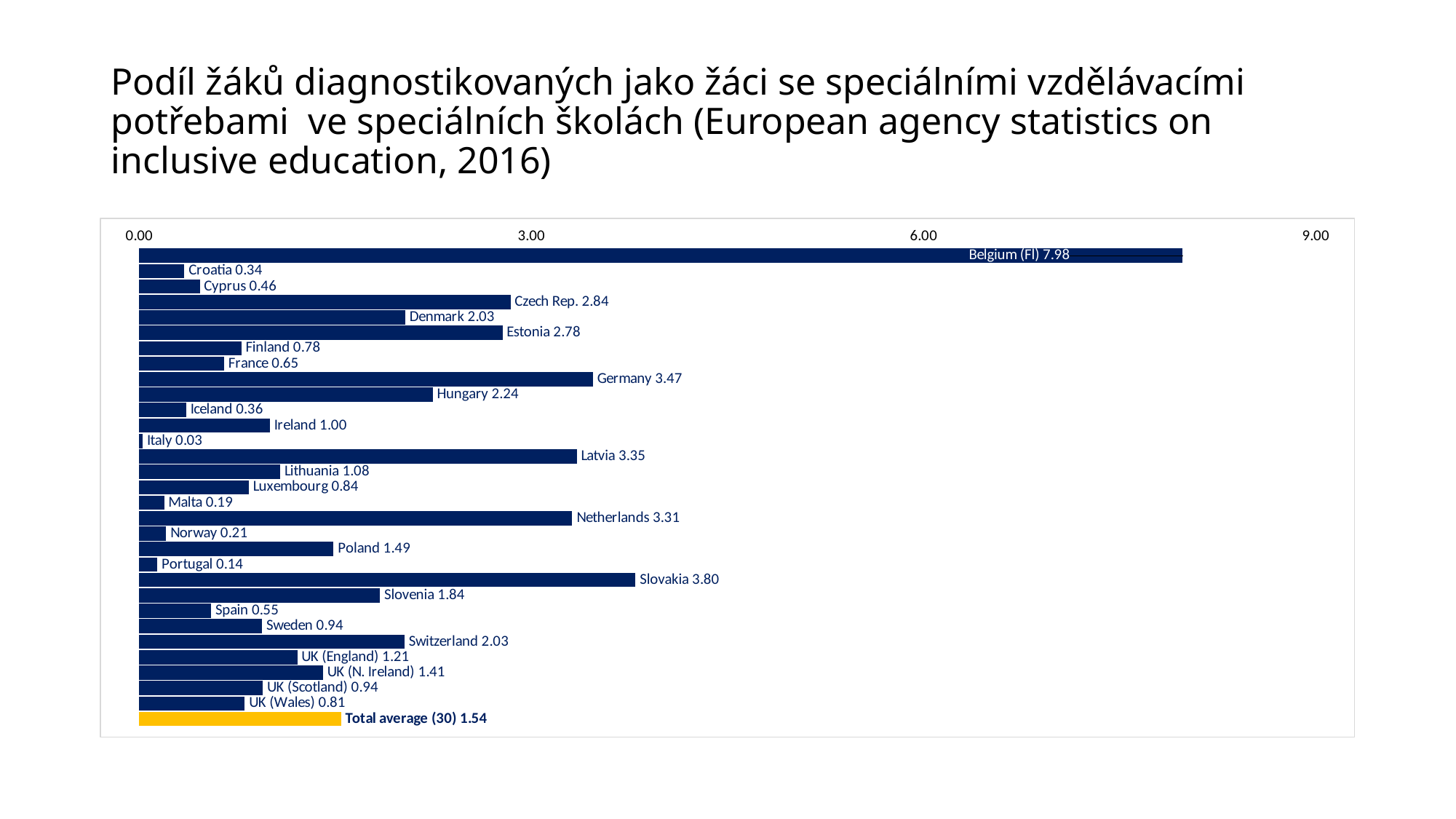
Which has a larger value, Latvia or Netherlands? Latvia Is the value for Czech Rep. greater or less than 3.00? less What kind of chart is shown on the slide? bar chart How many country bars are shown, excluding the Total average bar? 30 Which bar is coloured differently (yellow) from the others? Total average (30) What is the value for Germany? 3.47 What is the difference between the values for Denmark and Switzerland? 0.00 What is the value shown for Total average (30)? 1.54 What is the value for Slovakia? 3.80 What is the difference between the values for Belgium (Fl) and Slovakia? 4.18 Which country has the lowest value? Italy Which country has the highest value? Belgium (Fl)